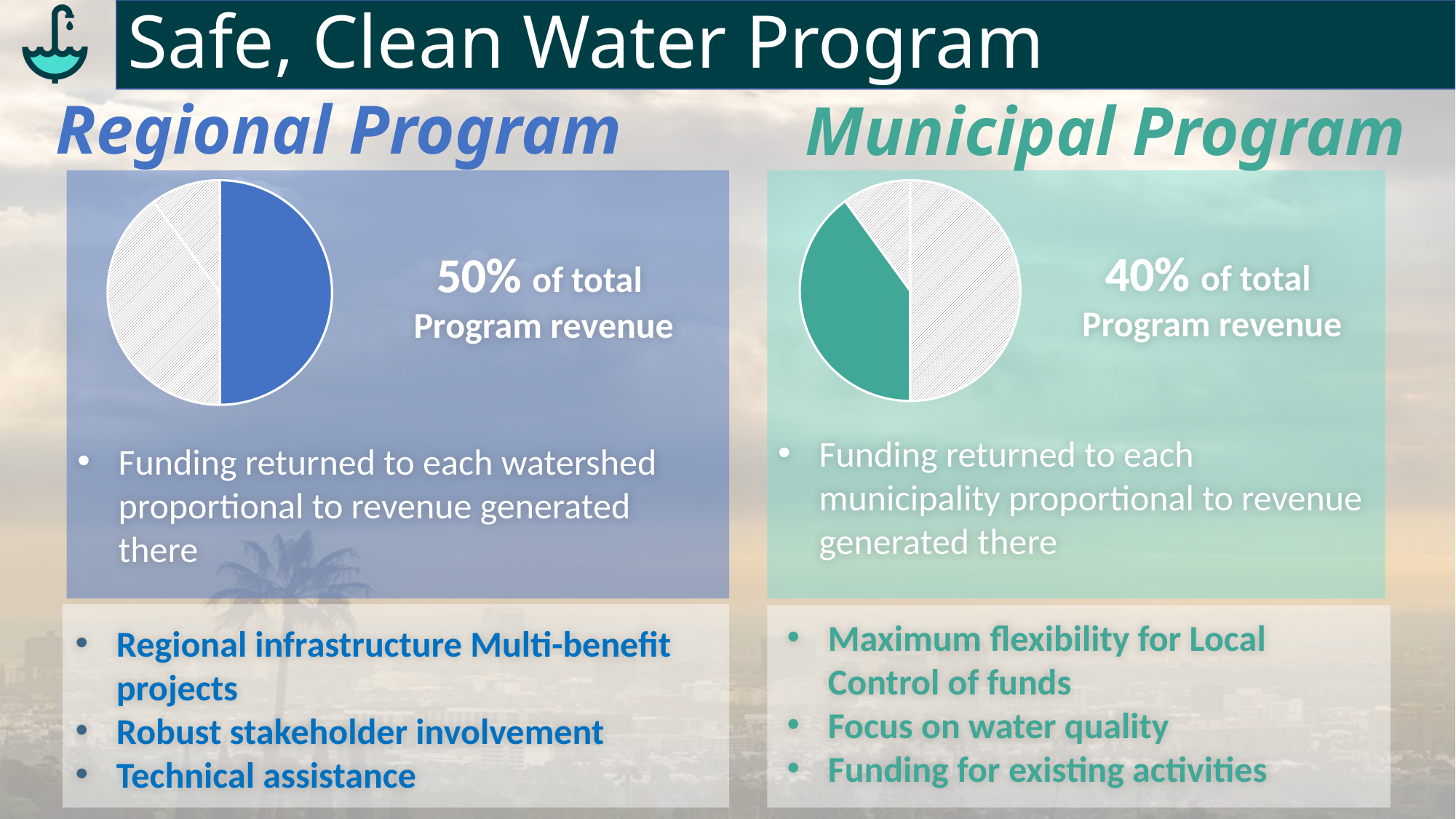
By how many percentage points does the Regional Program's share of total Program revenue exceed the Municipal Program's share? 10 percentage points How many slices does the Municipal Program pie chart have? 3 How many slices does the Regional Program pie chart have? 3 Is the Municipal Program's share of total Program revenue greater or less than 50%? less What colour is the highlighted slice in the Municipal Program pie chart? Teal What kind of chart is shown under the Regional Program heading? Pie chart What kind of chart is shown under the Municipal Program heading? Pie chart On the Municipal Program chart, what share of total Program revenue does the solid teal slice represent? 40% Which program's highlighted slice represents a larger share of total Program revenue, Regional or Municipal? Regional What colour is the highlighted slice in the Regional Program pie chart? Blue On the Regional Program chart, what share of total Program revenue does the solid blue slice represent? 50%